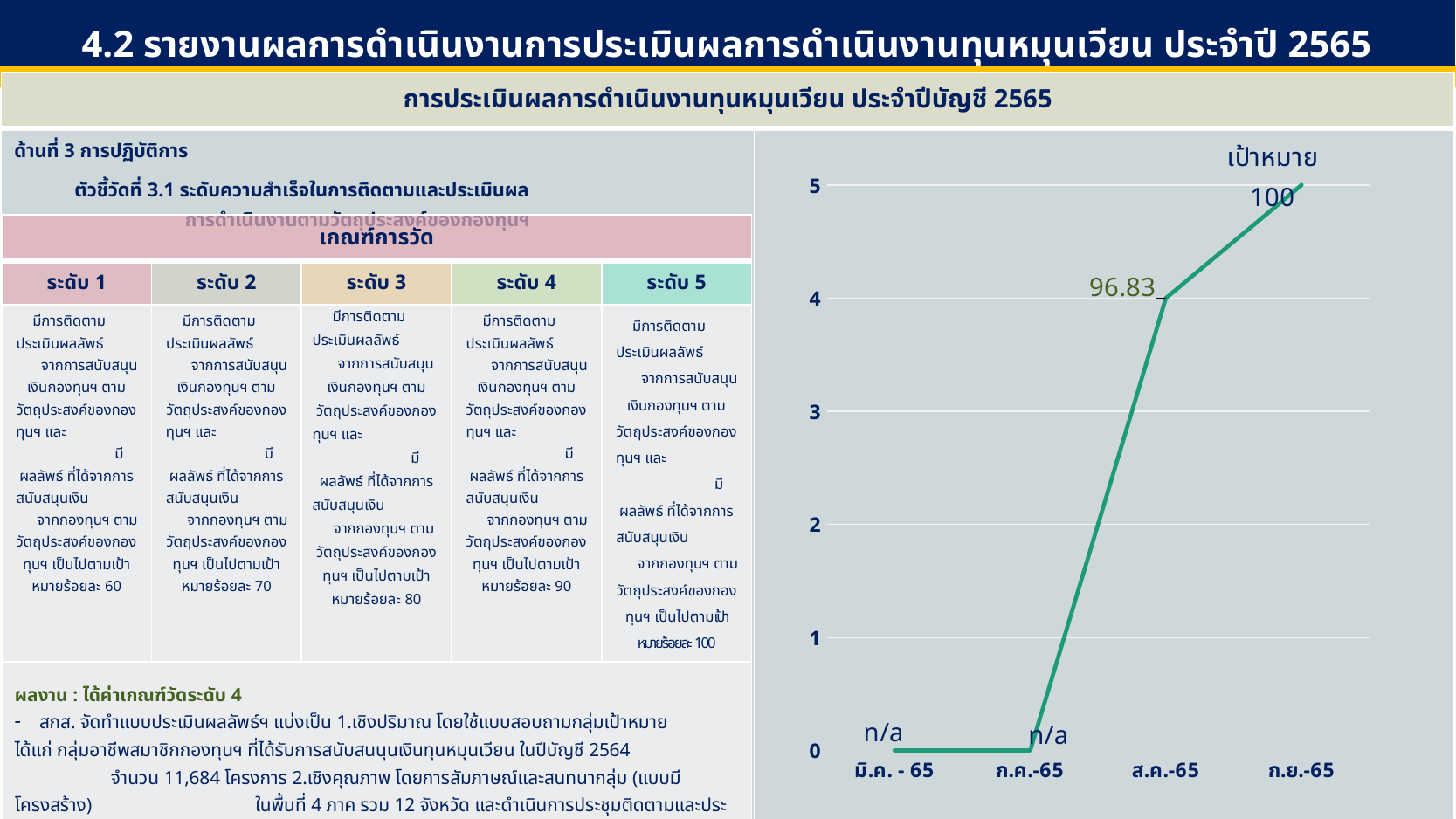
What data label is shown for มิ.ค. - 65 on the line chart? n/a What kind of chart is shown on the right side of the slide? line chart What data label is shown for ก.ย.-65 on the line chart? 100 What data label is shown for ก.ค.-65 on the line chart? n/a On the line chart, which x-axis category has the highest plotted point? ก.ย.-65 What word is printed above the last data point (100) on the line chart? เป้าหมาย On the line chart, is the plotted point for ส.ค.-65 greater or less than 3? greater How many categories are shown on the x axis of the line chart? 4 On the line chart, which axis tick does the point for ก.ย.-65 land on? 5 Does the line on the chart rise or fall from ก.ค.-65 to ก.ย.-65? rise What data label is shown for ส.ค.-65 on the line chart? 96.83 On the line chart, which axis tick does the point for ส.ค.-65 land on? 4